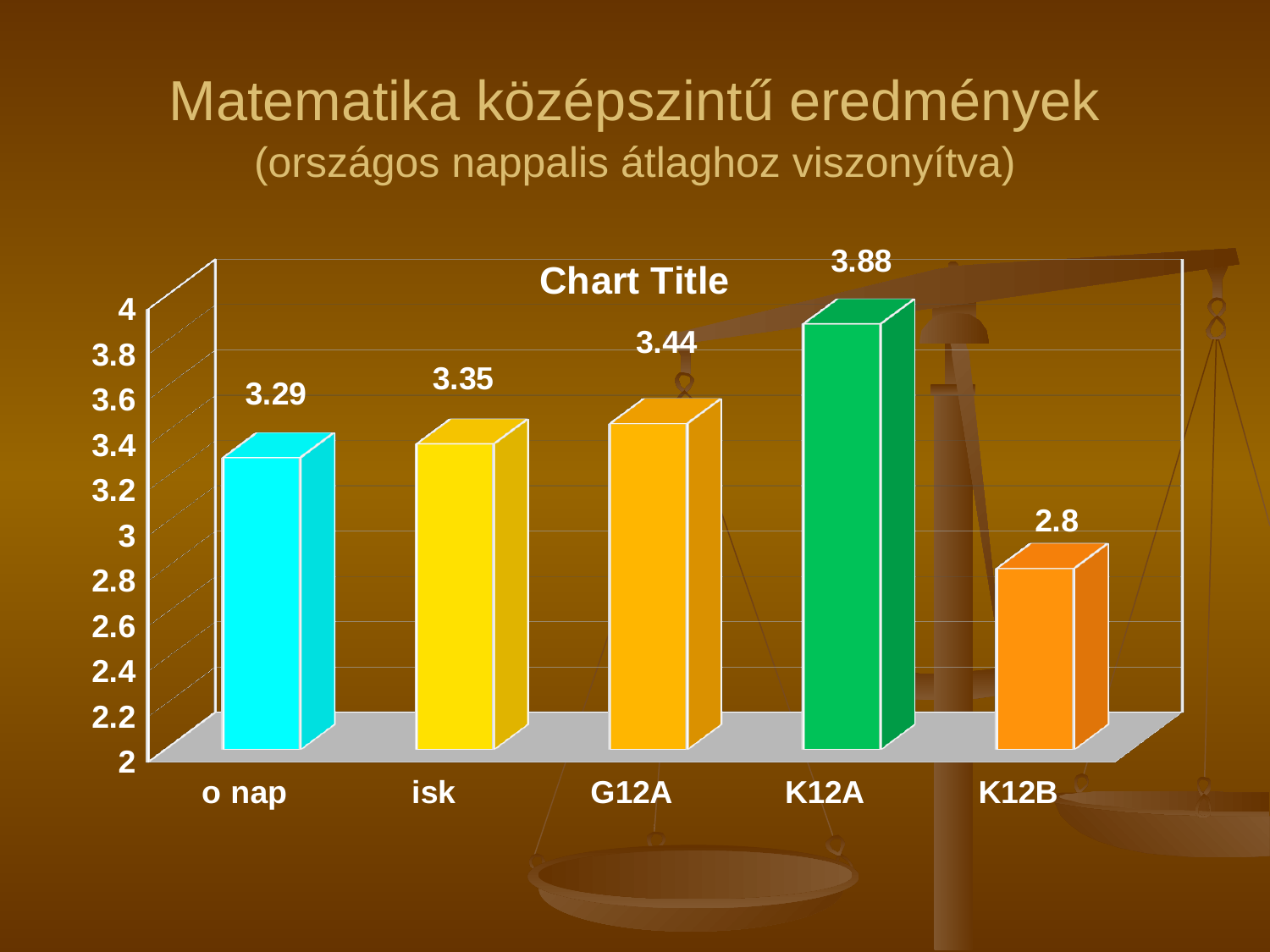
What is the value for G12A? 3.44 Which is larger, the value for G12A or the value for isk? G12A Which category has the lowest value? K12B What is the difference between the values for isk and o nap? 0.06 What kind of chart is shown on the slide? bar chart What is the value for K12A? 3.88 What is the value for K12B? 2.8 What is the title printed inside the chart area? Chart Title How many categories are shown on the x axis? 5 Which category has the highest value? K12A What is the difference between the values for K12A and K12B? 1.08 What is the value for o nap? 3.29